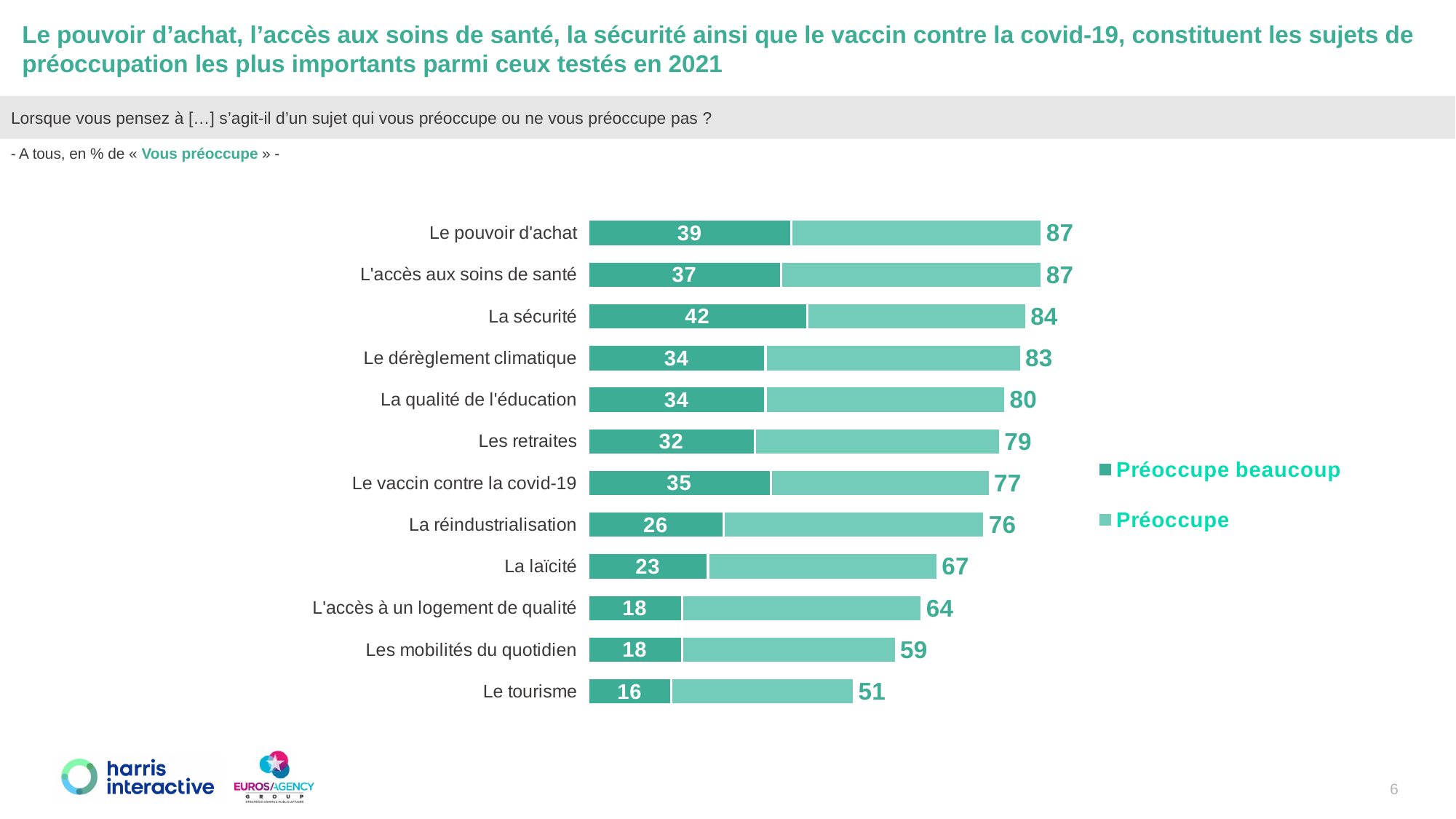
How many series does the legend list? 2 Do the total 'Préoccupe' values rise or fall going down the list of topics from top to bottom? fall What is the difference between the total 'Préoccupe' values for 'Le pouvoir d'achat' and 'Le tourisme'? 36 Which topic has the lowest total 'Préoccupe' value? Le tourisme What is the 'Préoccupe beaucoup' value for 'La sécurité'? 42 Which has a larger 'Préoccupe beaucoup' value: 'La réindustrialisation' or 'La laïcité'? La réindustrialisation What are the two legend entries of the chart? Préoccupe beaucoup; Préoccupe What is the difference between the 'Préoccupe beaucoup' values for 'Le pouvoir d'achat' and 'L'accès aux soins de santé'? 2 How many topics (categories) are listed in the chart? 12 Which topic has the highest 'Préoccupe beaucoup' value? La sécurité What kind of chart is shown on the slide? bar chart What is the total 'Préoccupe' value for 'Le vaccin contre la covid-19'? 77